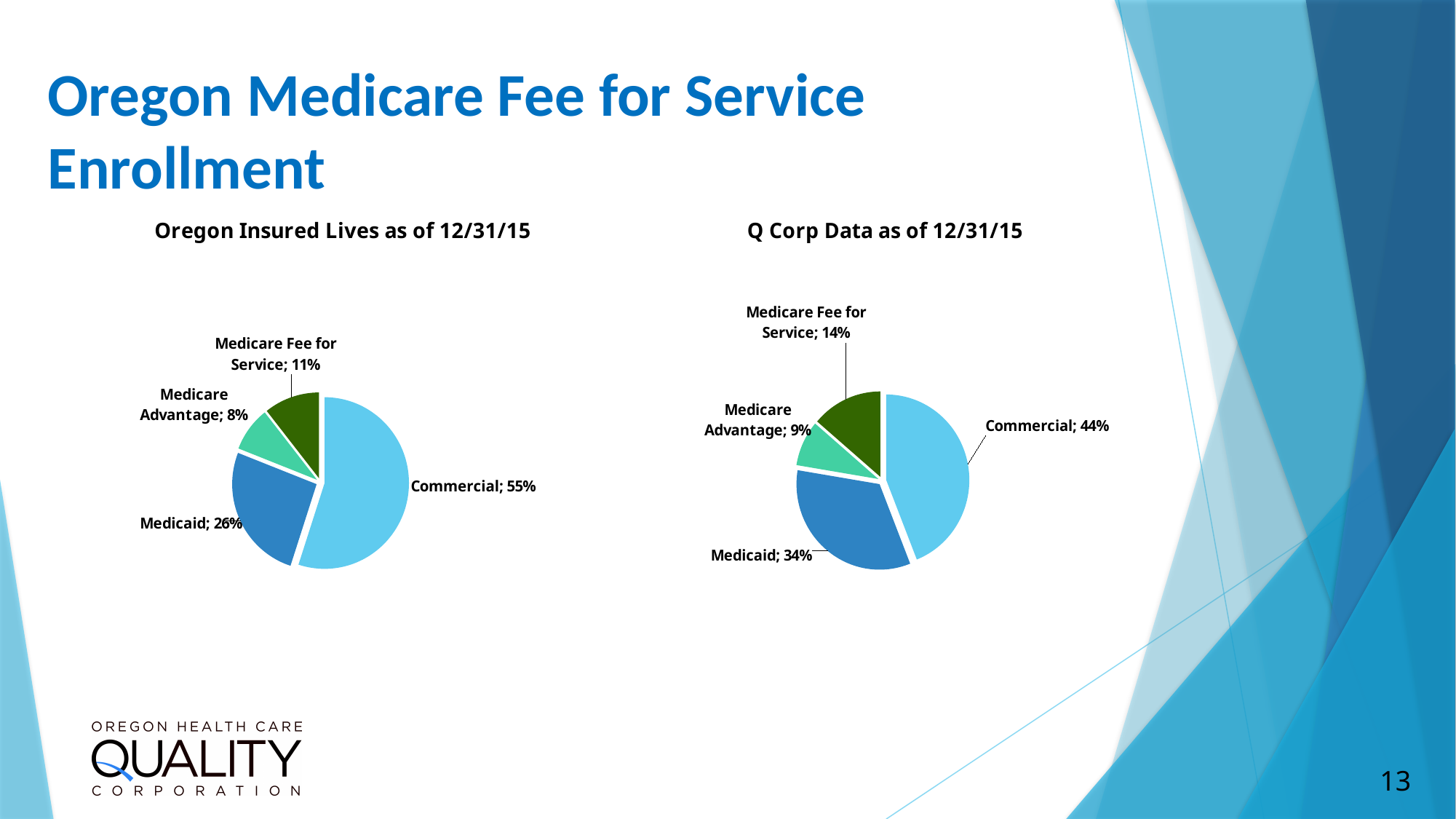
In the 'Q Corp Data as of 12/31/15' chart, what share does Medicare Advantage have? 9% What kind of chart is the 'Oregon Insured Lives as of 12/31/15' chart? Pie chart What is the difference between the Medicaid share in the 'Q Corp Data as of 12/31/15' chart and the Medicaid share in the 'Oregon Insured Lives as of 12/31/15' chart? 8% In the 'Q Corp Data as of 12/31/15' chart, what share does Medicaid have? 34% How many categories are shown in the 'Q Corp Data as of 12/31/15' chart? 4 Which is larger: the Medicare Fee for Service share in the 'Oregon Insured Lives as of 12/31/15' chart or in the 'Q Corp Data as of 12/31/15' chart? Q Corp Data as of 12/31/15 In the 'Q Corp Data as of 12/31/15' chart, which category has the smallest slice? Medicare Advantage What is the title of the chart on the right side of the slide? Q Corp Data as of 12/31/15 In the 'Oregon Insured Lives as of 12/31/15' chart, what share does Commercial have? 55% In the 'Oregon Insured Lives as of 12/31/15' chart, which category has the largest slice? Commercial In the 'Oregon Insured Lives as of 12/31/15' chart, what share does Medicare Fee for Service have? 11% In the 'Oregon Insured Lives as of 12/31/15' chart, which category has the smallest slice? Medicare Advantage